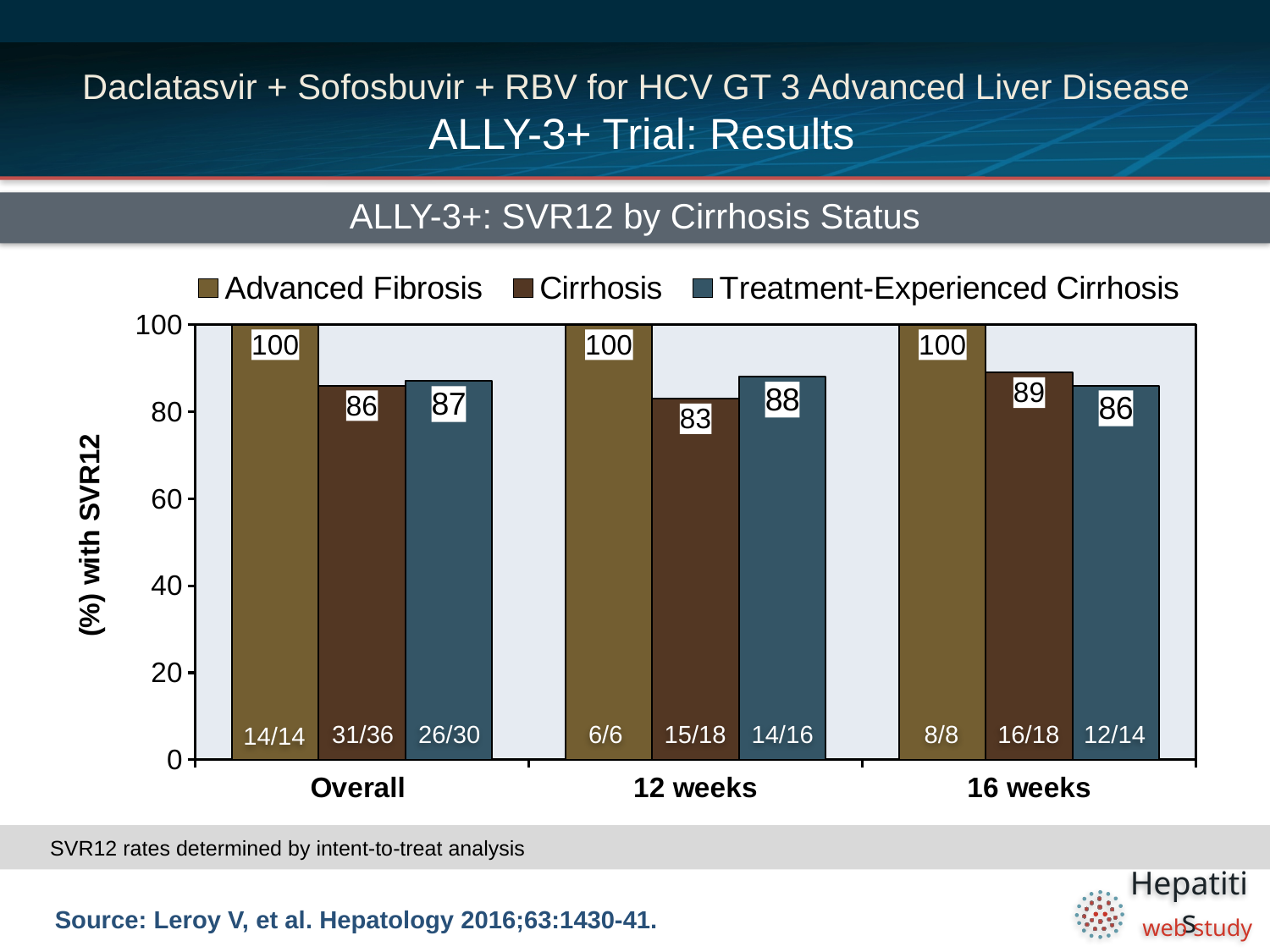
What is the SVR12 rate for Treatment-Experienced Cirrhosis at 12 weeks? 88 What is the difference between the Advanced Fibrosis and Cirrhosis SVR12 rates at 12 weeks? 17 What kind of chart is shown on the slide? Bar chart What is the SVR12 rate for Cirrhosis at 16 weeks? 89 Which series has the lowest SVR12 rate at 12 weeks? Cirrhosis At 16 weeks, which is larger: the SVR12 rate for Cirrhosis or for Treatment-Experienced Cirrhosis? Cirrhosis How many groups are shown on the x axis? 3 How many series does the legend list? 3 What fraction of patients is shown for Advanced Fibrosis in the Overall group? 14/14 Which series has the highest SVR12 rate at 16 weeks? Advanced Fibrosis What is the SVR12 rate for Cirrhosis in the Overall group? 86 What is the title of the chart? ALLY-3+: SVR12 by Cirrhosis Status